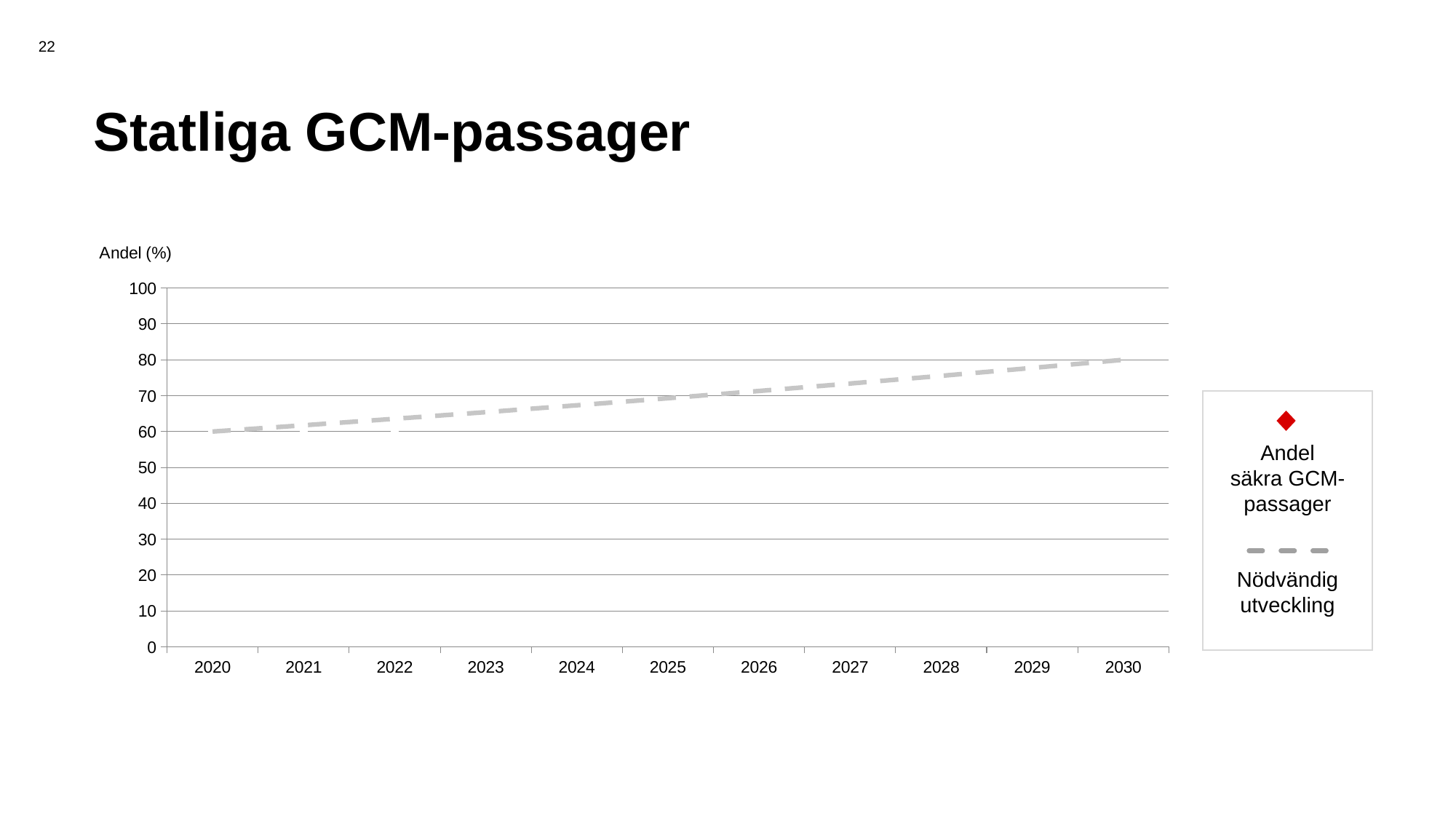
Does the Nödvändig utveckling line rise or fall from 2020 to 2030? rise Is the value of the Nödvändig utveckling line in 2028 greater or less than 70? greater What is the value of the Nödvändig utveckling line in 2020? 60 Is the value of the Nödvändig utveckling line in 2023 greater or less than 70? less What is the value of the Nödvändig utveckling line in 2030? 80 Is the value of the Nödvändig utveckling line in 2025 greater or less than 60? greater What kind of chart is shown on the slide? line chart By how much does the Nödvändig utveckling line increase from 2020 to 2030? 20 How many years are shown on the x axis? 11 What is the title of the slide? Statliga GCM-passager How many series does the legend list? 2 What is the label of the y axis? Andel (%)